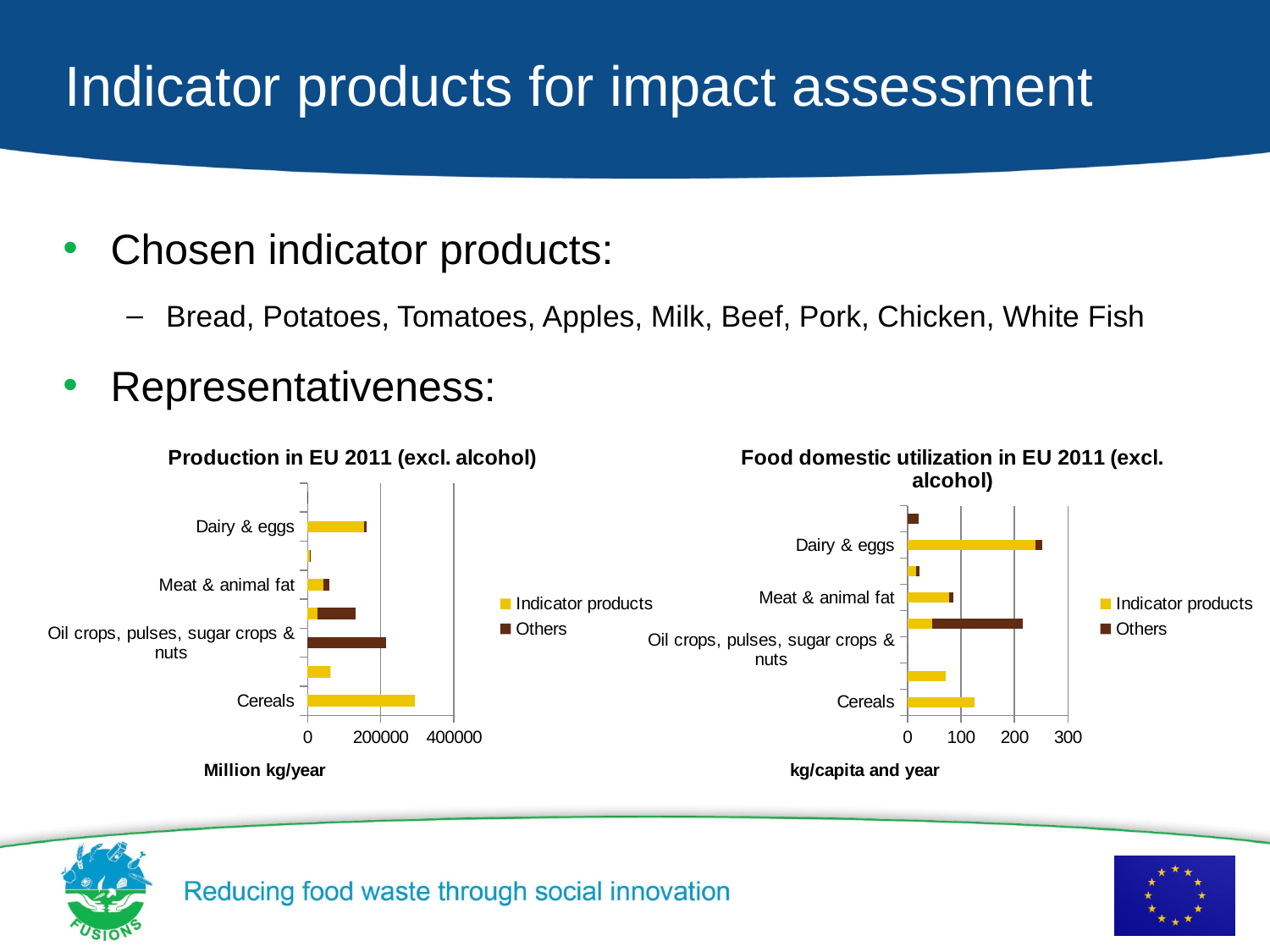
What unit is shown on the x axis of the 'Production in EU 2011 (excl. alcohol)' chart? Million kg/year In the 'Production in EU 2011 (excl. alcohol)' chart, which labelled category has the longest Indicator products bar? Cereals In the 'Food domestic utilization in EU 2011 (excl. alcohol)' chart, is the Indicator products value for Meat & animal fat greater or less than 100? less In the 'Food domestic utilization in EU 2011 (excl. alcohol)' chart, is the Indicator products value for Dairy & eggs greater or less than 200? greater What kind of chart is the 'Production in EU 2011 (excl. alcohol)' chart? bar chart How many series does the legend of the 'Food domestic utilization in EU 2011 (excl. alcohol)' chart list? 2 In the 'Production in EU 2011 (excl. alcohol)' chart, is the Indicator products value for Cereals greater or less than 200000? greater In the 'Production in EU 2011 (excl. alcohol)' chart, which is larger: the Indicator products value for Cereals or for Dairy & eggs? Cereals In the 'Food domestic utilization in EU 2011 (excl. alcohol)' chart, which is larger: the Indicator products value for Dairy & eggs or for Cereals? Dairy & eggs In the 'Food domestic utilization in EU 2011 (excl. alcohol)' chart, which labelled category has the longest Indicator products bar? Dairy & eggs